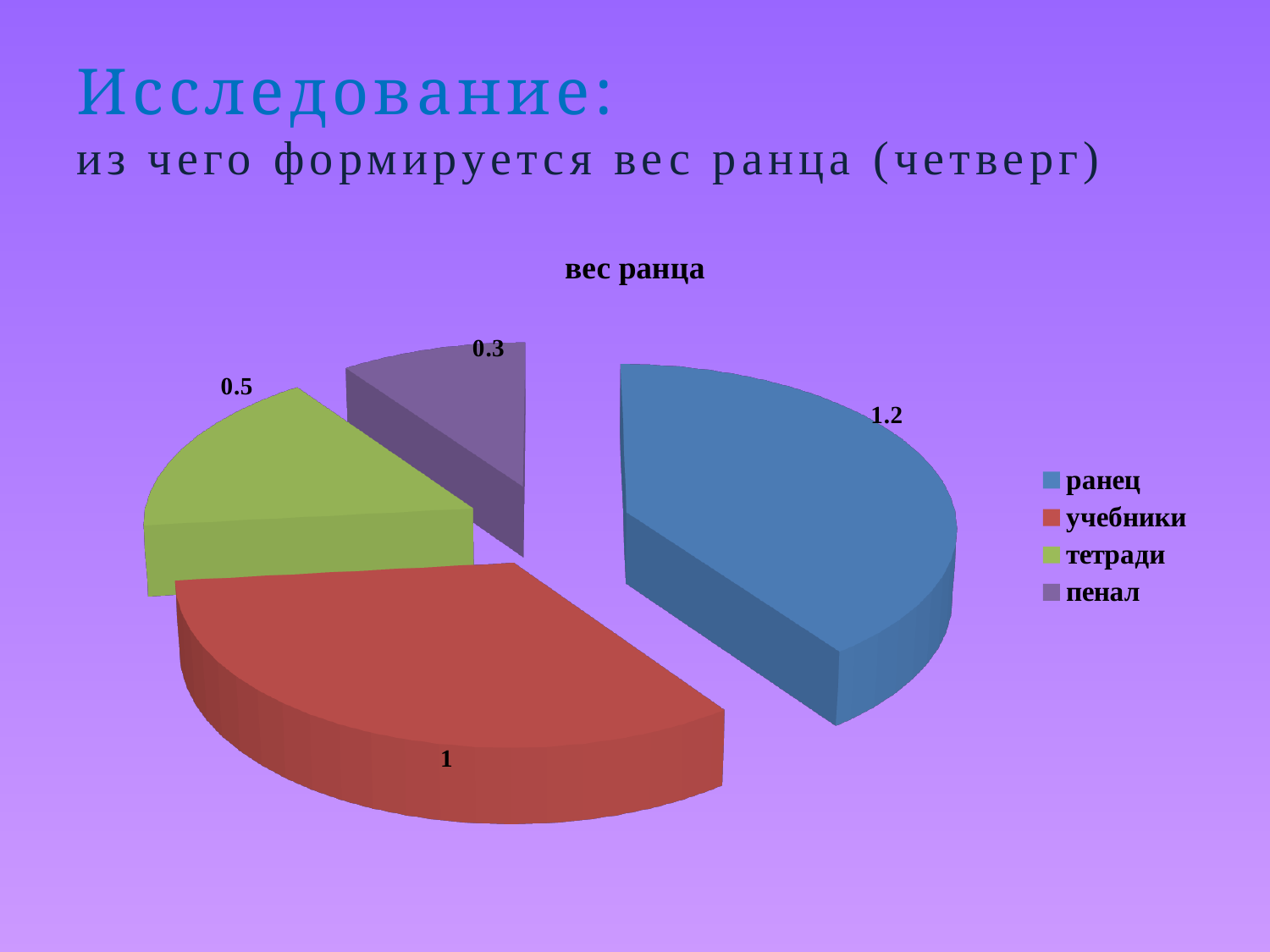
What type of chart is shown on the slide? pie chart What is the value for тетради in the pie chart? 0.5 Which is larger, the value for тетради or the value for пенал? тетради What is the value for учебники in the pie chart? 1 What is the difference between the values for ранец and учебники? 0.2 Which category has the largest slice in the pie chart? ранец Which category has the smallest slice in the pie chart? пенал What is the title of the chart? вес ранца What share of the pie does the пенал slice represent? 10% What is the value for пенал in the pie chart? 0.3 How many categories are shown in the pie chart? 4 What is the value for ранец in the pie chart? 1.2